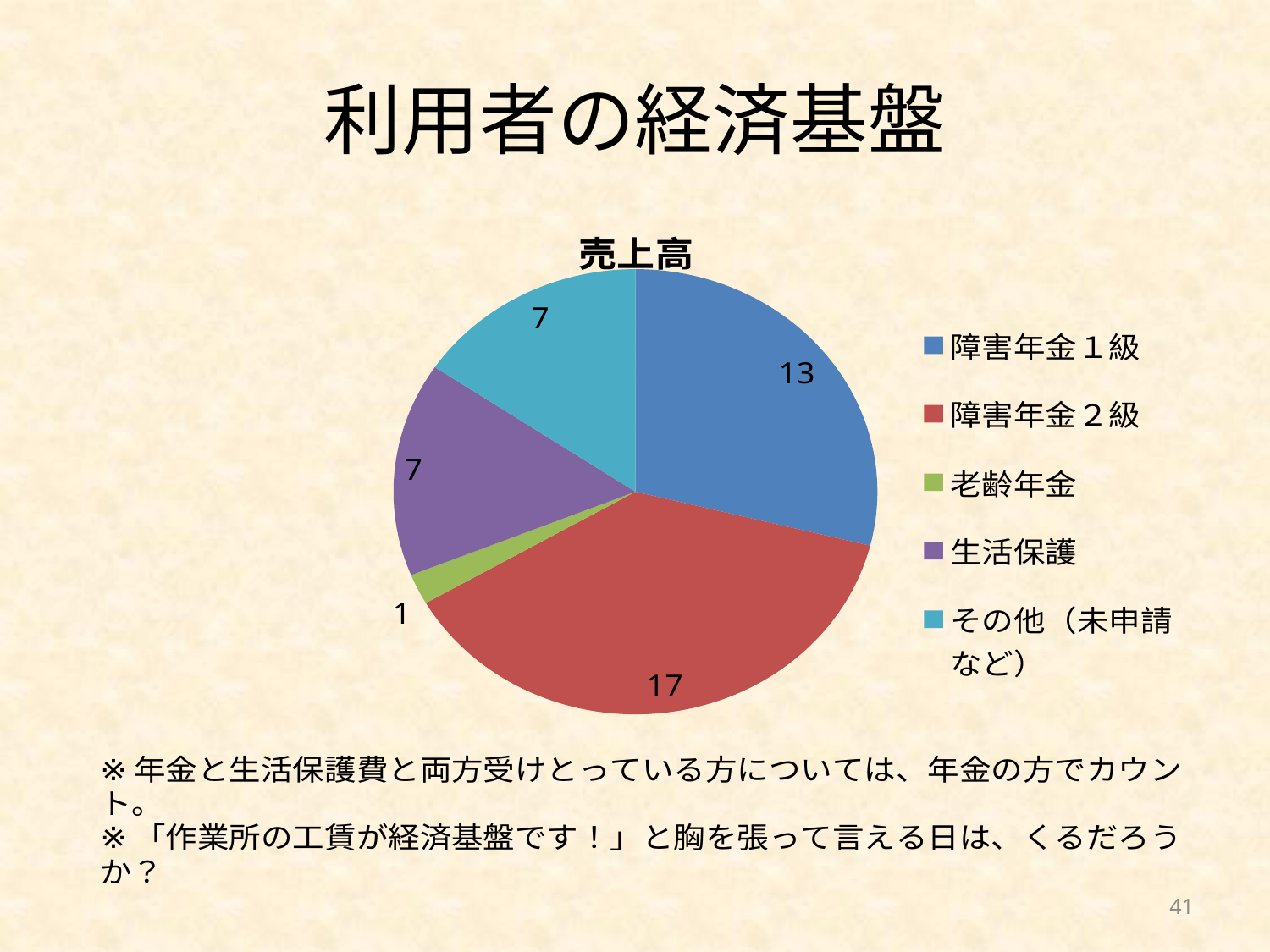
What is the title of the pie chart? 売上高 Which category has the largest slice of the pie chart? 障害年金２級 What is the total of all the values shown in the pie chart? 45 What is the value for 障害年金２級 in the pie chart? 17 What is the value for 生活保護 in the pie chart? 7 What is the value for 老齢年金 in the pie chart? 1 Which is larger, the value for 障害年金１級 or the value for 生活保護? 障害年金１級 What kind of chart is shown on the slide? pie chart What is the difference between the values for 障害年金２級 and 障害年金１級? 4 Which category has the smallest slice of the pie chart? 老齢年金 How many categories does the pie chart show? 5 What is the value for 障害年金１級 in the pie chart? 13